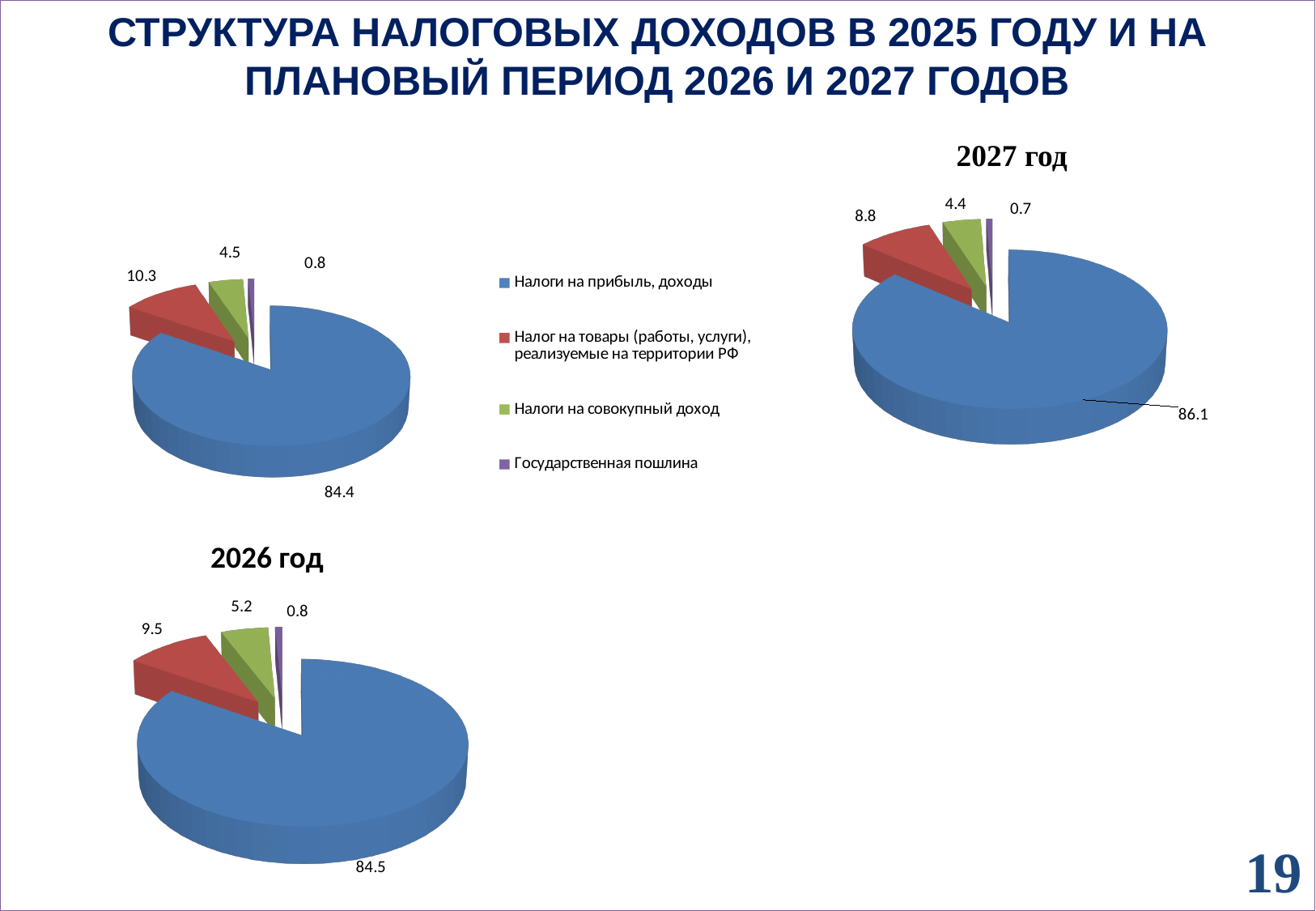
In the pie chart titled "2026 год", which is larger: the value for "Налоги на совокупный доход" or the value for "Государственная пошлина"? Налоги на совокупный доход In the pie chart titled "2027 год", what is the difference between the values for "Налог на товары (работы, услуги), реализуемые на территории РФ" and "Налоги на совокупный доход"? 4.4 In the top-left pie chart, which category has the smallest slice? Государственная пошлина In the pie chart titled "2026 год", which category has the largest slice? Налоги на прибыль, доходы In the pie chart titled "2026 год", what is the value for "Налог на товары (работы, услуги), реализуемые на территории РФ"? 9.5 In the pie chart titled "2027 год", what is the value for "Налоги на прибыль, доходы"? 86.1 How many slices does the pie chart titled "2027 год" have? 4 Which colour represents "Налог на товары (работы, услуги), реализуемые на территории РФ" in the legend? Red How many entries does the legend on the slide list? 4 What type of chart is the chart titled "2026 год"? Pie chart In the top-left pie chart, what is the value for "Налоги на совокупный доход"? 4.5 In the pie chart titled "2027 год", what is the value for "Государственная пошлина"? 0.7